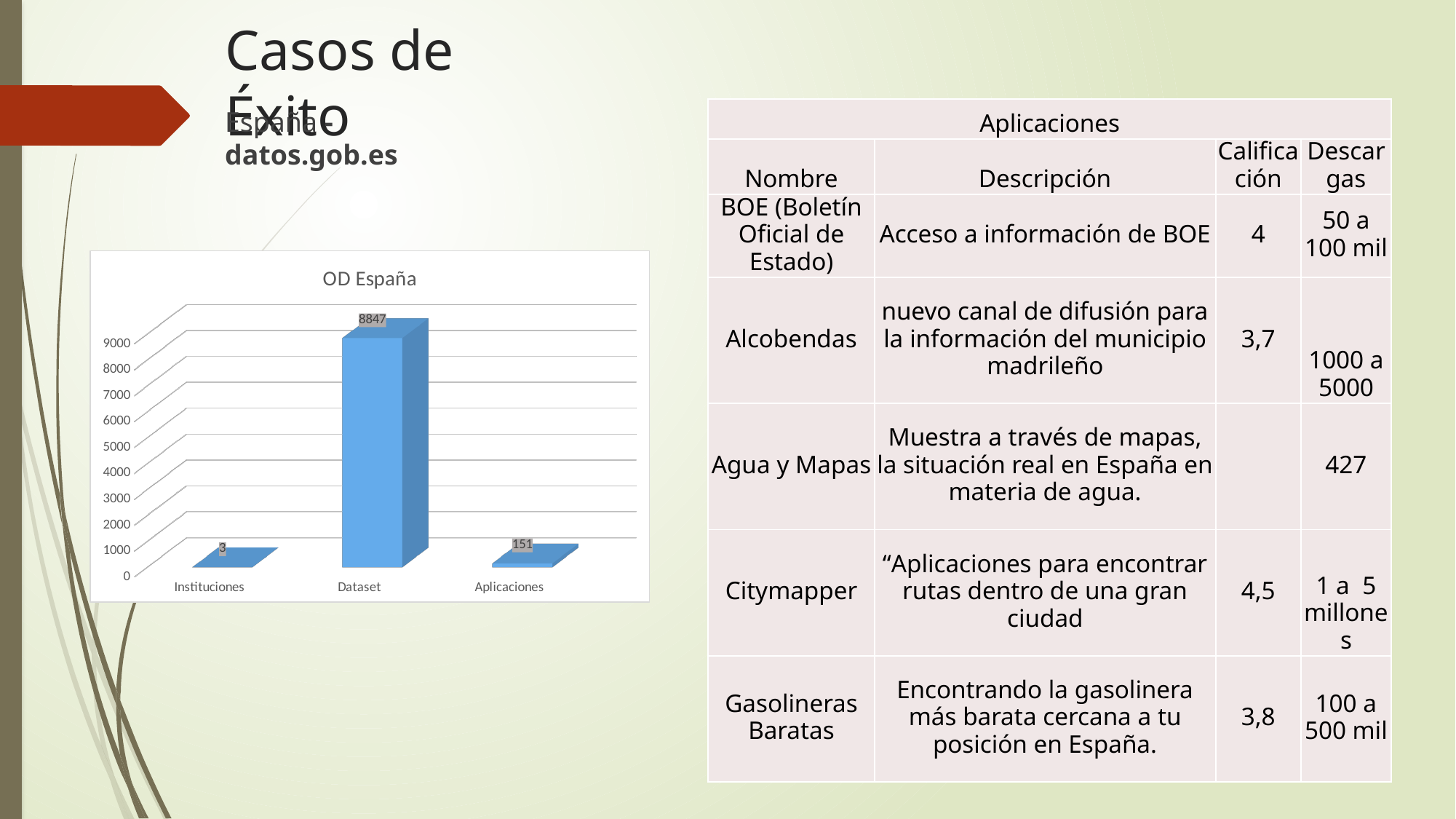
What is the value for Instituciones in the OD España chart? 3 How many categories are shown in the OD España chart? 3 What is the title of the chart on the slide? OD España Which is larger in the OD España chart, Aplicaciones or Instituciones? Aplicaciones What is the value for Dataset in the OD España chart? 8847 Which category has the highest value in the OD España chart? Dataset What is the difference between the Aplicaciones and Instituciones values in the OD España chart? 148 What is the value for Aplicaciones in the OD España chart? 151 Is the value for Dataset in the OD España chart greater or less than 8000? greater Which category has the lowest value in the OD España chart? Instituciones What is the difference between the Dataset and Aplicaciones values in the OD España chart? 8696 What kind of chart is the OD España chart? bar chart